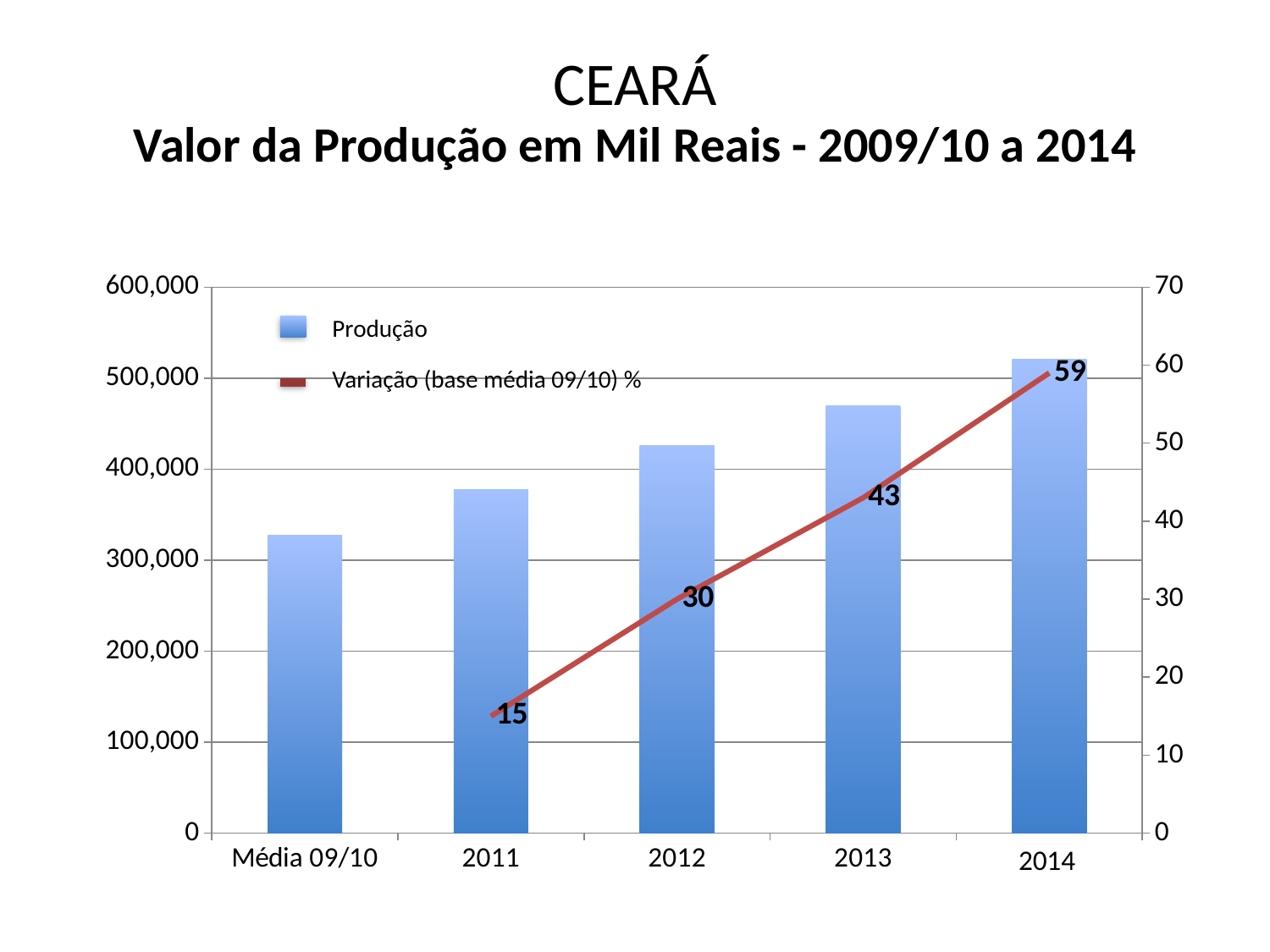
Which is larger, the Variação value for 2012 or for 2013? 2013 How many categories are shown on the x axis? 5 Does the Variação line rise or fall from 2011 to 2014? rise What is the difference between the Variação values for 2014 and 2012? 29 How many series does the legend list? 2 Is the Produção value for 2014 greater or less than 500,000? greater What is the Variação (base média 09/10) % value for 2014? 59 What is the Variação (base média 09/10) % value for 2013? 43 Which category has the highest Produção bar? 2014 What is the Variação (base média 09/10) % value for 2011? 15 Which category has the lowest Produção bar? Média 09/10 Is the Produção value for 2011 greater or less than 400,000? less